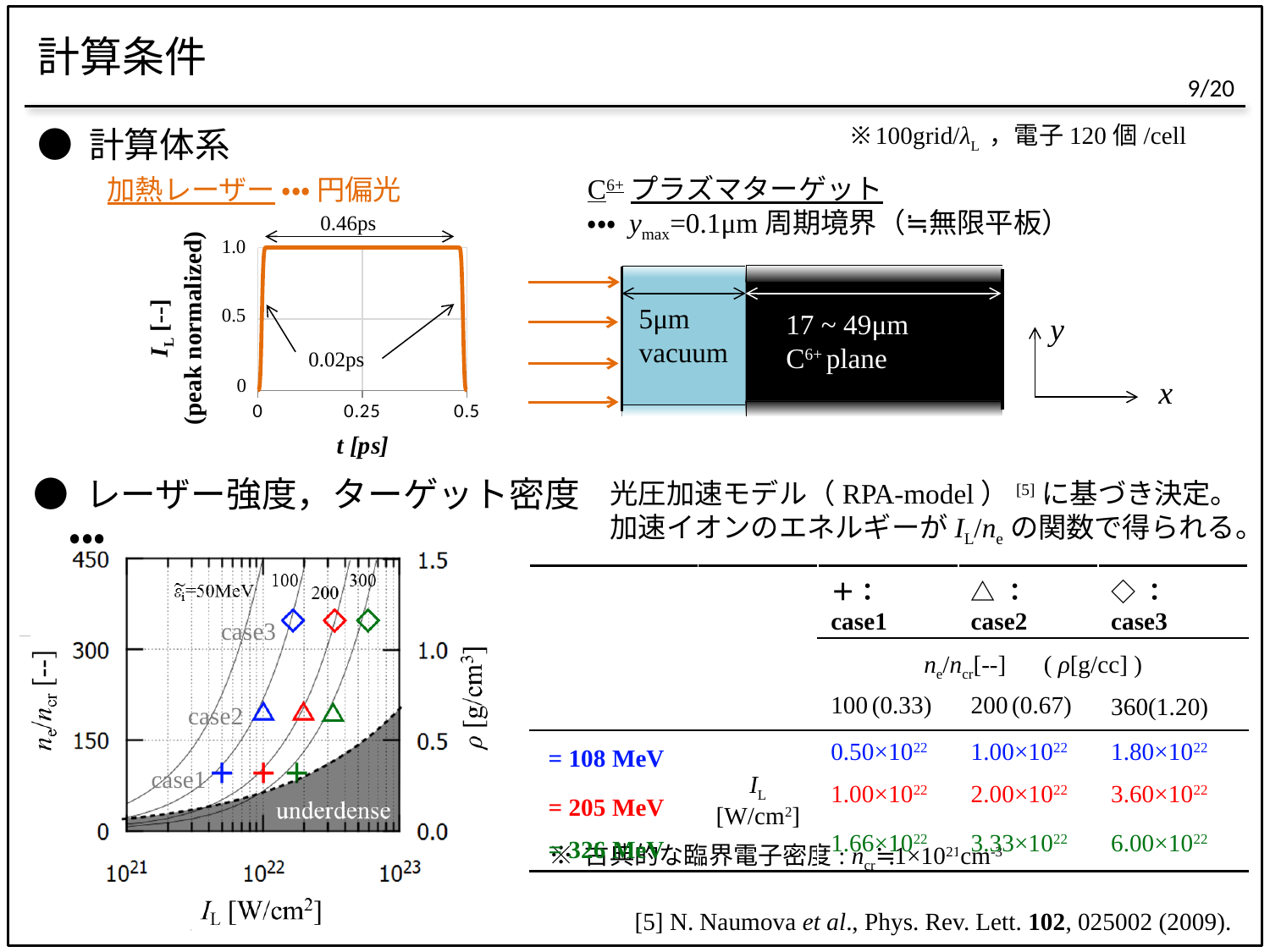
In the bottom-left chart of n_e/n_cr versus I_L, is the n_e/n_cr value for case3 greater or less than 300? greater In the top-left chart of I_L versus t, what time is labeled for the rise and fall of the pulse? 0.02ps In the top-left chart of I_L versus t, what is the x-axis label? t [ps] In the bottom-left chart of n_e/n_cr versus I_L, is the n_e/n_cr value for case1 greater or less than 150? less In the top-left chart of I_L versus t, what is the peak normalized value the pulse reaches? 1.0 In the bottom-left chart of n_e/n_cr versus I_L, which case has the highest n_e/n_cr? case3 In the bottom-left chart of n_e/n_cr versus I_L, what is the label of the shaded region? underdense In the bottom-left chart of n_e/n_cr versus I_L, how many data points are plotted in total? 9 What kind of chart is the bottom-left chart of n_e/n_cr versus I_L? scatter plot In the bottom-left chart of n_e/n_cr versus I_L, how many cases (marker types) are plotted? 3 What kind of chart is the top-left chart of I_L versus t? line chart In the top-left chart of I_L versus t, what duration is labeled for the flat top of the pulse? 0.46ps